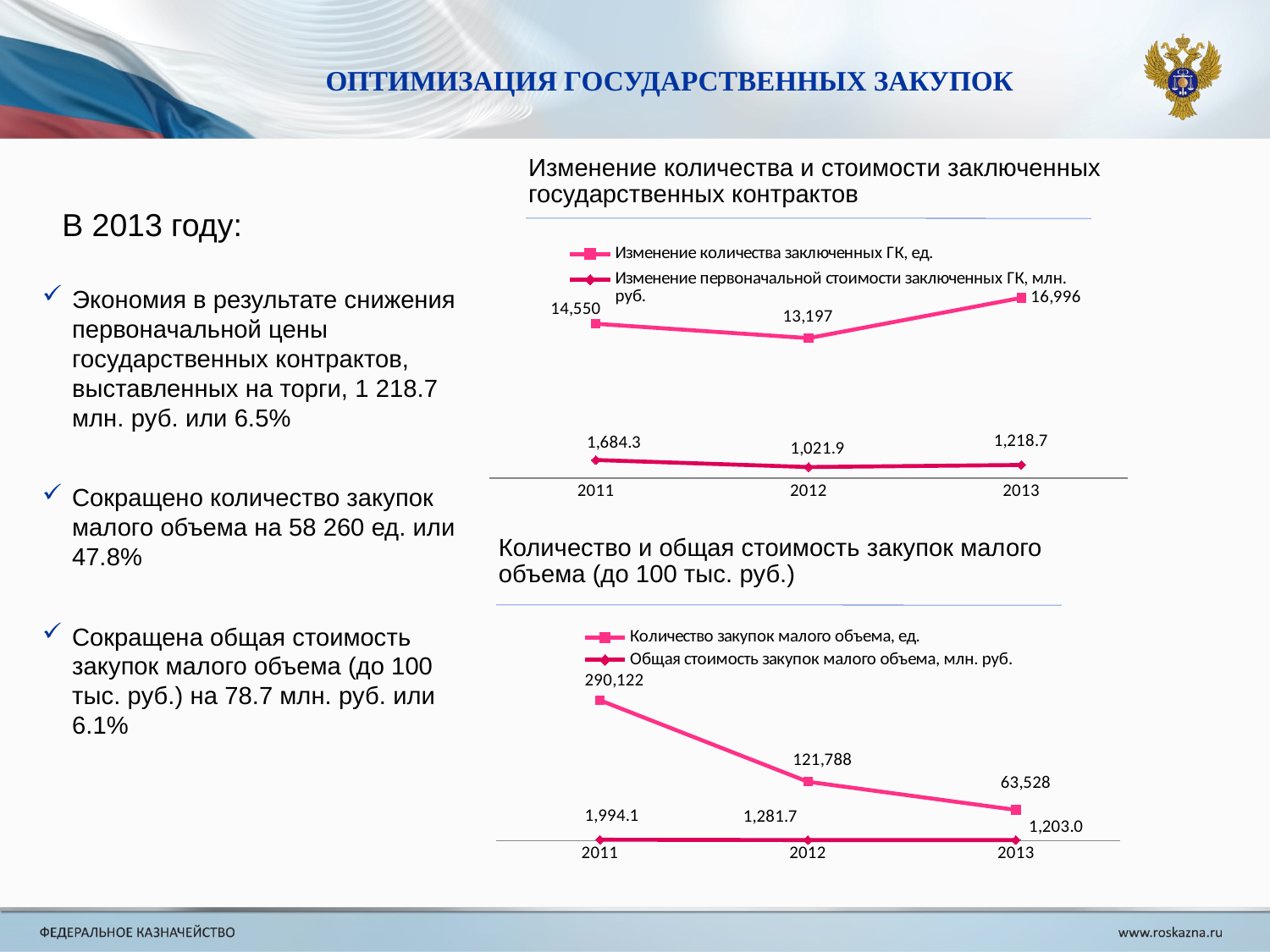
In the bottom chart, what is the value of 'Общая стоимость закупок малого объема, млн. руб.' for 2013? 1,203.0 In the bottom chart (Количество и общая стоимость закупок малого объема), what is the value of 'Количество закупок малого объема, ед.' for 2011? 290,122 What type of chart is the top chart? Line chart In the top chart (Изменение количества и стоимости заключенных государственных контрактов), what is the value of 'Изменение количества заключенных ГК, ед.' for 2013? 16,996 In the bottom chart, what is the difference between the 2011 and 2012 values of 'Общая стоимость закупок малого объема, млн. руб.'? 712.4 In the top chart, what is the value of 'Изменение первоначальной стоимости заключенных ГК, млн. руб.' for 2011? 1,684.3 In the top chart, which year has the lowest value for 'Изменение количества заключенных ГК, ед.'? 2012 In the bottom chart, how many years are shown on the x axis? 3 In the bottom chart, does the 'Количество закупок малого объема, ед.' series rise or fall from 2011 to 2013? Fall In the top chart, what is the difference between the 2013 and 2012 values of 'Изменение количества заключенных ГК, ед.'? 3,799 In the top chart, how many series does the legend list? 2 In the bottom chart, which is larger: the 'Количество закупок малого объема, ед.' value for 2012 or for 2013? 2012